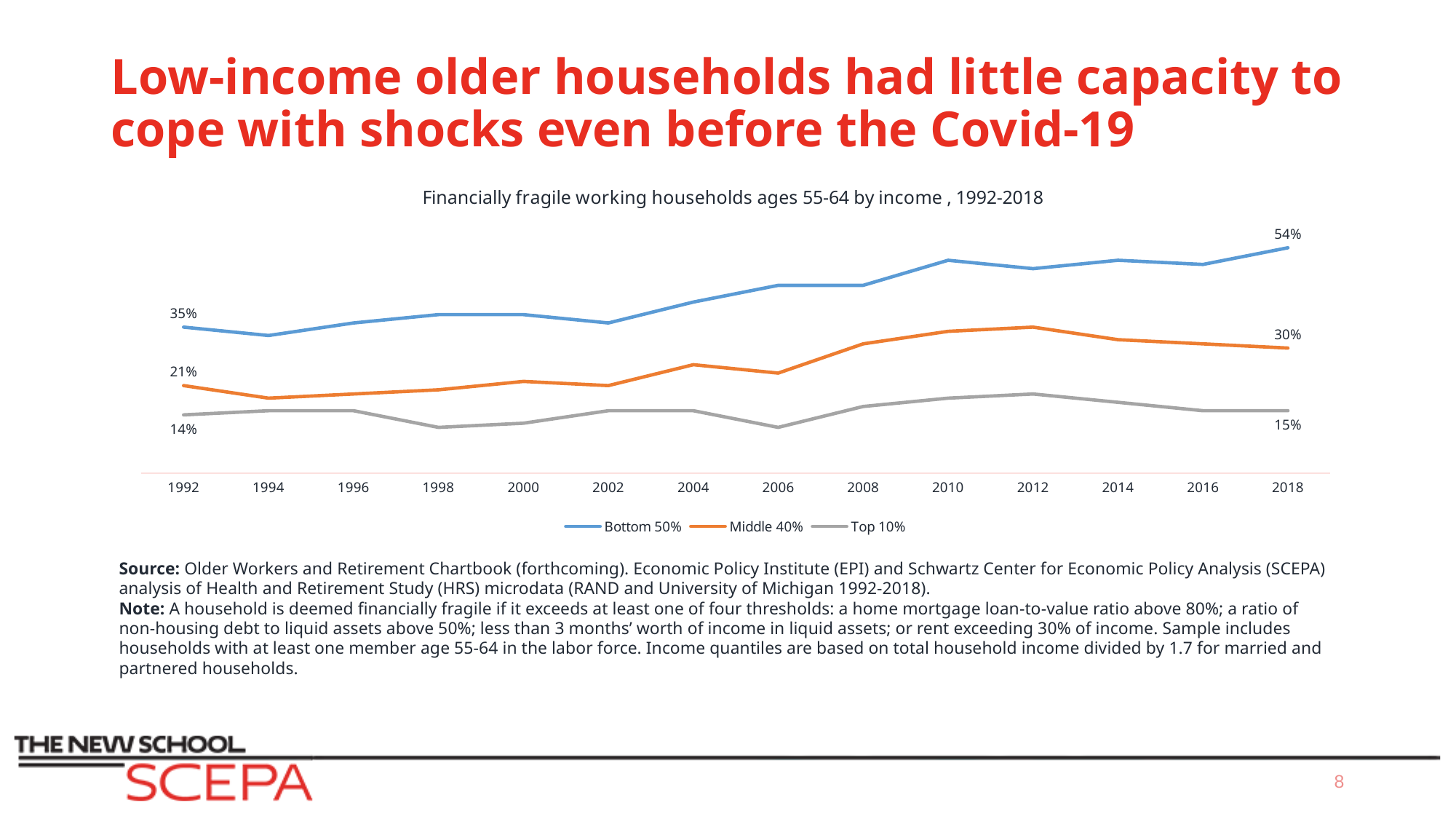
What kind of chart is shown on the slide? line chart Which series has the lowest value in 1992? Top 10% What is the value for Bottom 50% in 1992? 35% How many series does the legend list? 3 Is the Middle 40% value in 2018 larger or smaller than the Top 10% value in 2018? larger What is the value for Middle 40% in 1992? 21% By how many percentage points did the Bottom 50% value change from 1992 to 2018? 19 percentage points What is the value for Bottom 50% in 2018? 54% Does the Bottom 50% series generally rise or fall from 1992 to 2018? rise What is the value for Top 10% in 2018? 15% What is the difference between the Bottom 50% and Top 10% values in 2018? 39 percentage points Which series has the highest value in 2018? Bottom 50%